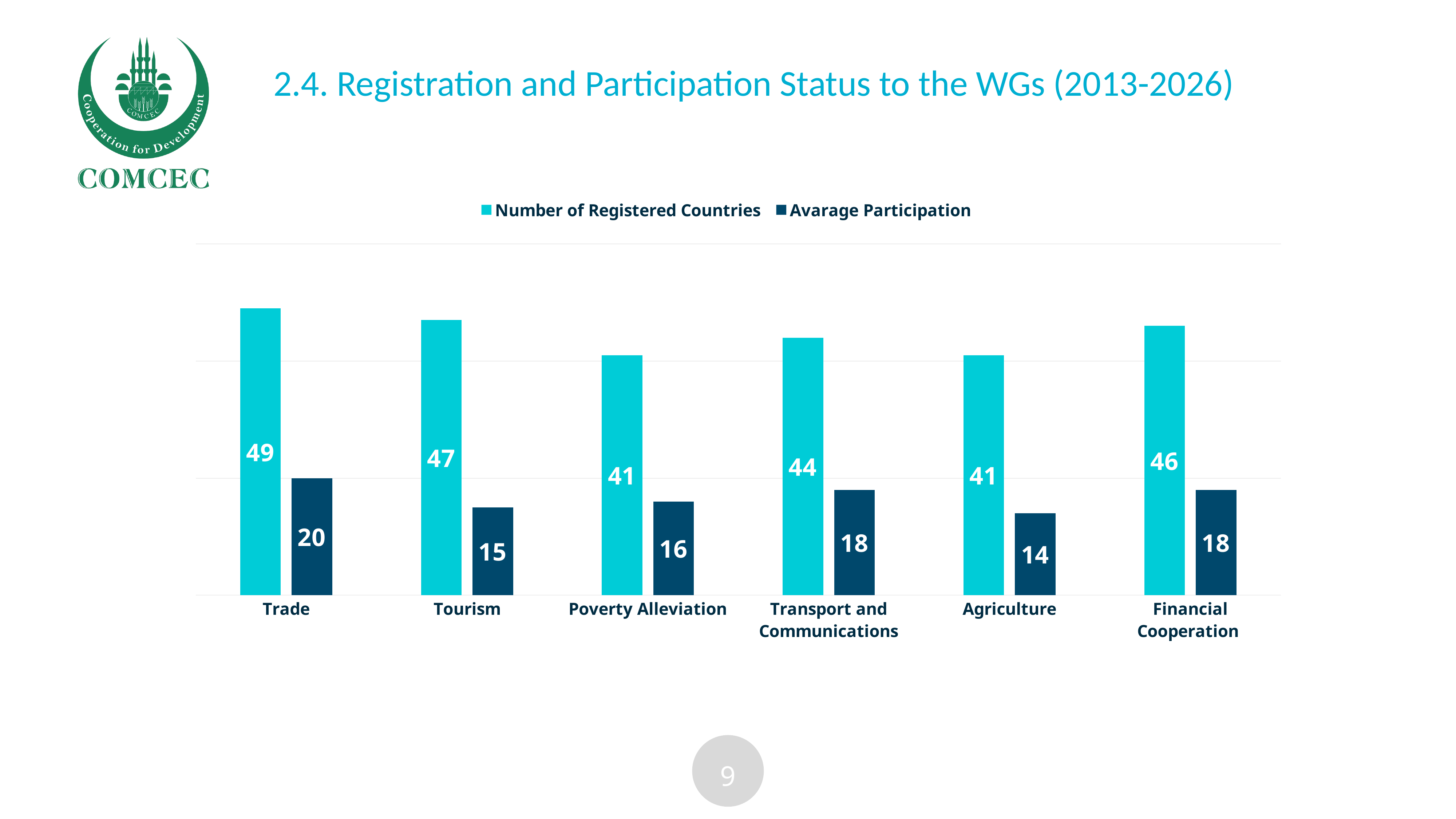
Which has a higher Avarage Participation, Trade or Poverty Alleviation? Trade How many working groups are shown on the x axis? 6 What is the Avarage Participation for Tourism? 15 Which series is shown in dark blue in the legend? Avarage Participation What is the Number of Registered Countries for Trade? 49 What is the difference in Number of Registered Countries between Trade and Agriculture? 8 What is the difference between the Number of Registered Countries and the Avarage Participation for Transport and Communications? 26 Which working group has the highest Number of Registered Countries? Trade Which working group has the lowest Avarage Participation? Agriculture What kind of chart is shown on the slide? Bar chart What is the Number of Registered Countries for Financial Cooperation? 46 How many series does the legend list? 2